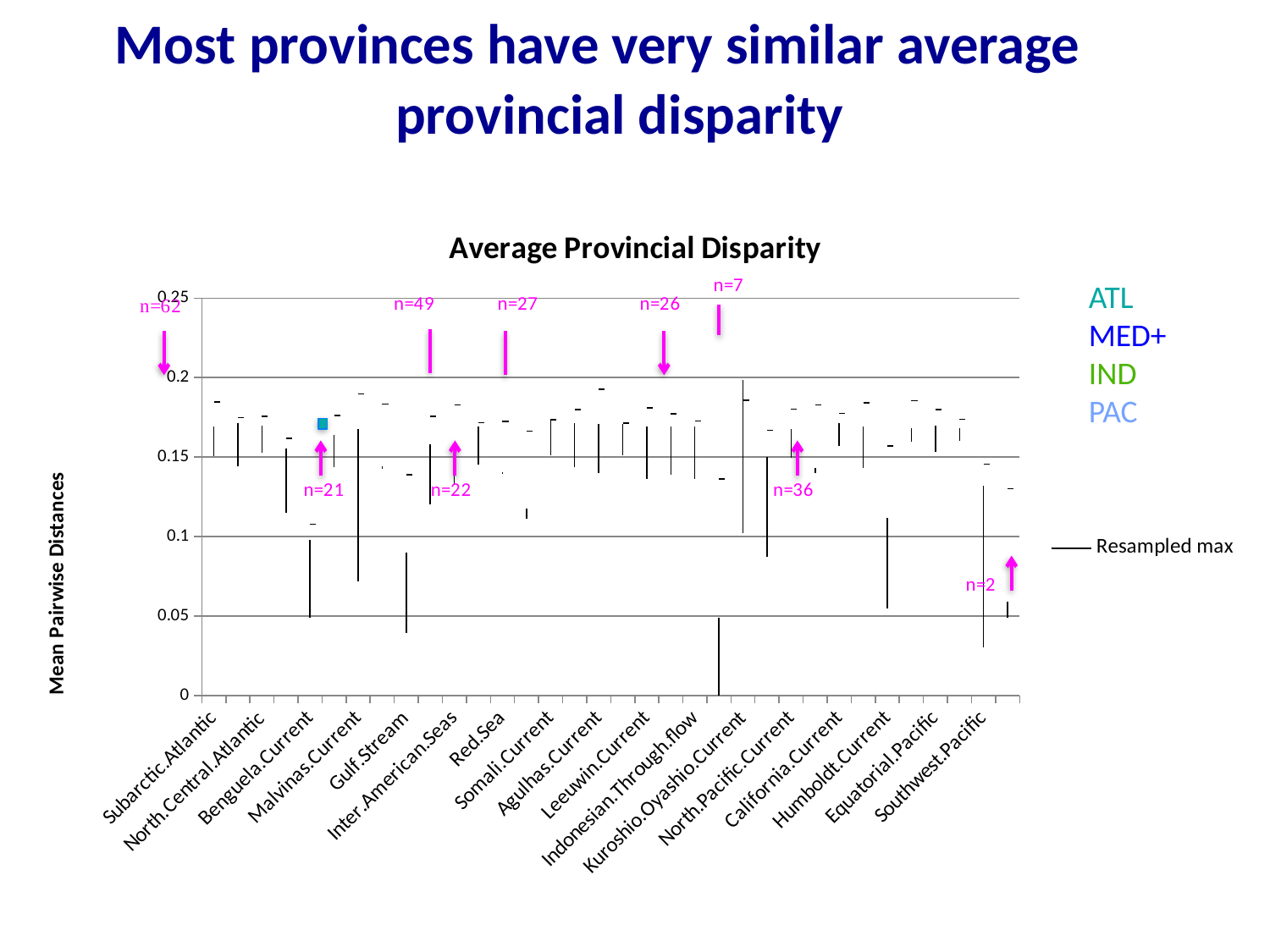
What is the largest sample size (n) annotated on the chart? n=62 How many 'n=' sample-size annotations are shown on the chart? 9 How many series does the chart legend list? 1 What is the name of the series shown in the chart legend? Resampled max What is the highest value shown on the vertical axis of the chart? 0.25 What sample size is annotated with the arrow pointing at Inter.American.Seas? n=22 What is the title of the chart? Average Provincial Disparity What is the smallest sample size (n) annotated on the chart? n=2 What sample size is annotated with the arrow pointing at North.Pacific.Current? n=36 How many province names are labeled along the x axis of the chart? 17 What is the label on the vertical axis of the chart? Mean Pairwise Distances